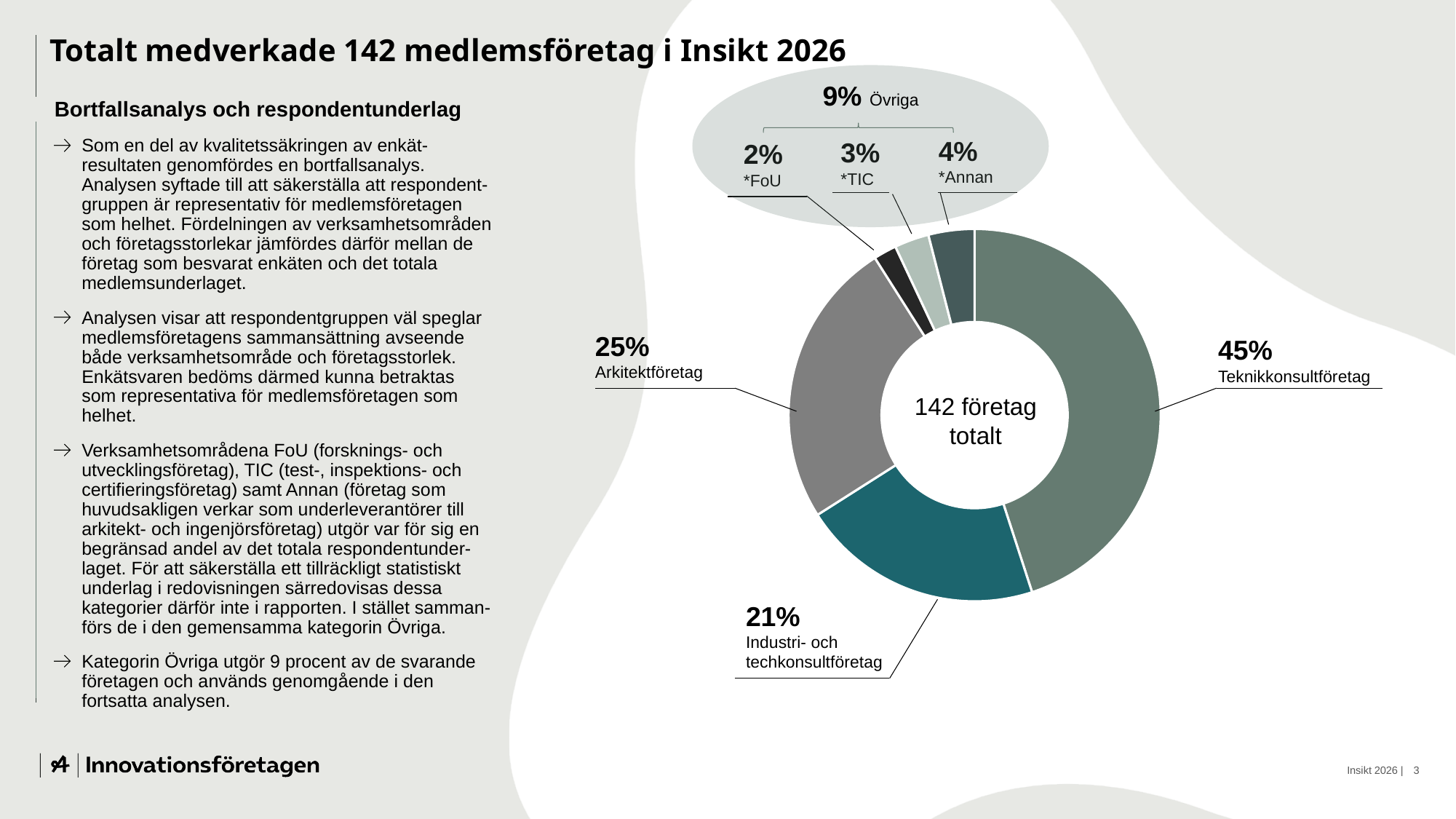
What share of the donut chart is Teknikkonsultföretag? 45% Which category has the largest share in the donut chart? Teknikkonsultföretag What share of the donut chart is TIC? 3% What share of the donut chart is Övriga? 9% What is the difference in percentage points between Teknikkonsultföretag and Arkitektföretag? 20 percentage points How many sub-categories make up the Övriga group in the chart? 3 Which of the three Övriga sub-categories (FoU, TIC, Annan) has the smallest share? FoU What total number of companies is shown in the centre of the donut chart? 142 företag totalt What share of the donut chart is Industri- och techkonsultföretag? 21% What kind of chart is shown on the slide? Donut (pie) chart Which is larger, the share for Arkitektföretag or the share for Industri- och techkonsultföretag? Arkitektföretag What share of the donut chart is Arkitektföretag? 25%